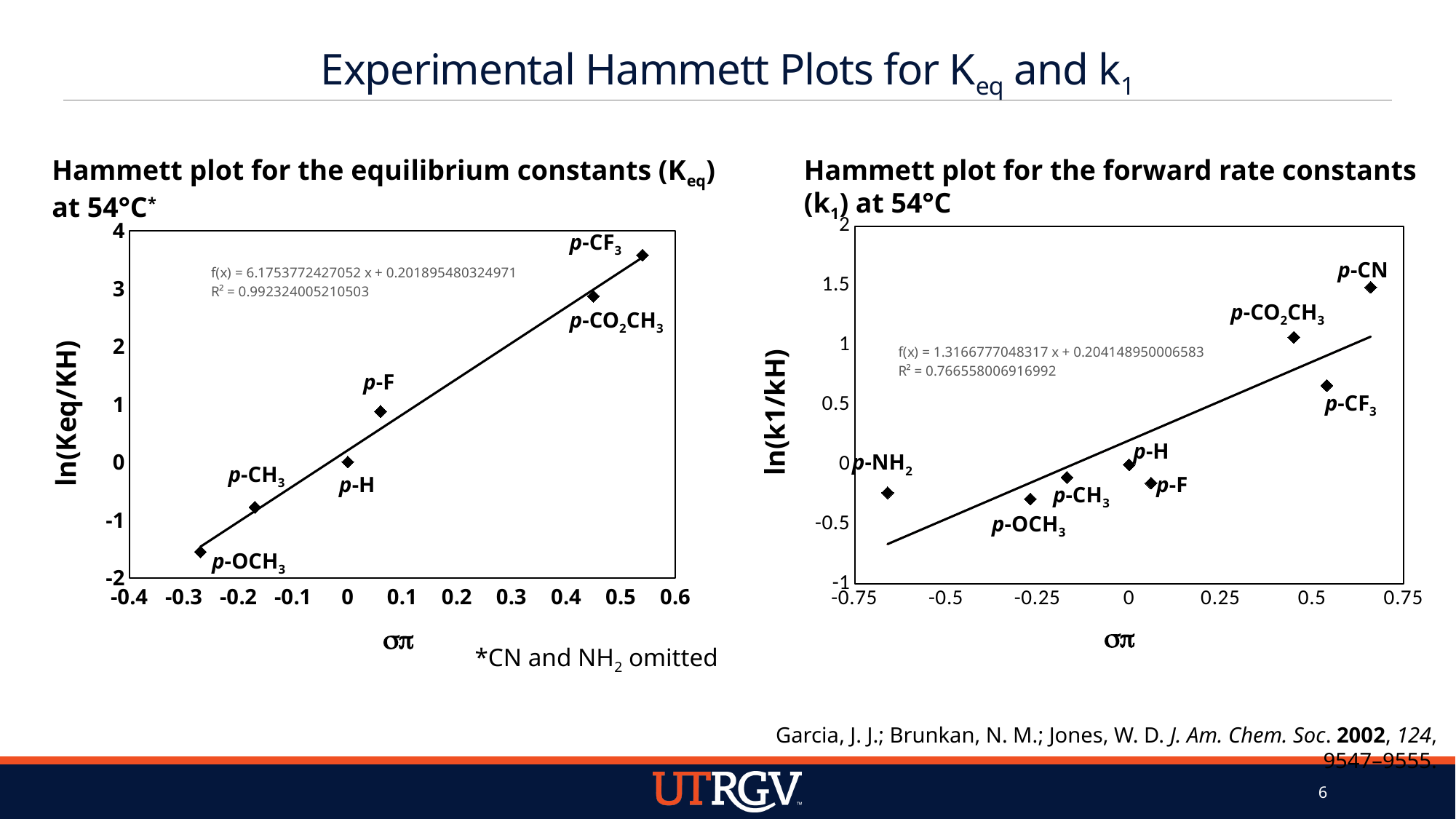
In the Hammett plot for the equilibrium constants (Keq), which substituent has the lowest ln(Keq/KH) value? p-OCH3 What is the R² value shown on the Hammett plot for the equilibrium constants (Keq)? 0.992324005210503 In the Hammett plot for the forward rate constants (k1), which has the larger ln(k1/kH) value, p-CO2CH3 or p-CF3? p-CO2CH3 How many data points are plotted in the Hammett plot for the forward rate constants (k1)? 8 How many data points are plotted in the Hammett plot for the equilibrium constants (Keq)? 6 In the Hammett plot for the forward rate constants (k1), is the ln(k1/kH) value for p-CF3 greater or less than 1? less In the Hammett plot for the equilibrium constants (Keq), is the ln(Keq/KH) value for p-CO2CH3 greater or less than 2? greater In the Hammett plot for the forward rate constants (k1), which substituent has the highest ln(k1/kH) value? p-CN What kind of chart is the Hammett plot for the equilibrium constants (Keq) at 54°C? scatter plot In the Hammett plot for the equilibrium constants (Keq), which substituent has the highest ln(Keq/KH) value? p-CF3 What is the R² value shown on the Hammett plot for the forward rate constants (k1)? 0.766558006916992 In the Hammett plot for the equilibrium constants (Keq), do the ln(Keq/KH) values rise or fall as σπ increases? rise